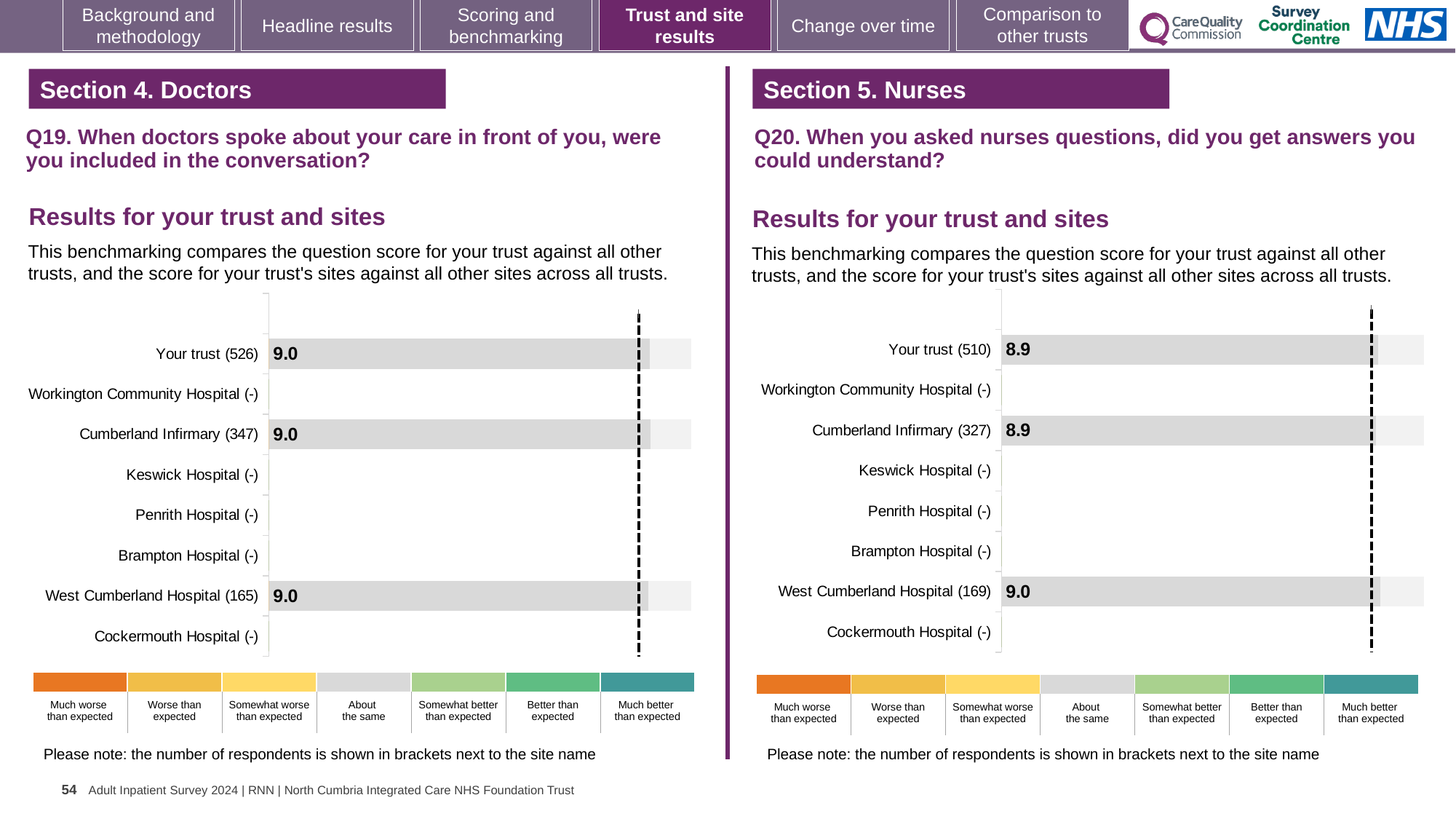
How many benchmark categories does the colour legend below the Q20 chart (right) list? 7 On the Q19 chart (left), how many categories have a plotted bar with a score? 3 On the Q19 chart (left), what is the score for West Cumberland Hospital (165)? 9.0 On the Q20 chart (right), which is larger: the score for West Cumberland Hospital (169) or the score for Cumberland Infirmary (327)? West Cumberland Hospital (169) What type of chart is used on the Q19 chart (left)? Bar chart On the Q20 chart (right), what is the difference between the score for West Cumberland Hospital (169) and the score for Your trust (510)? 0.1 On the Q20 chart (right), what is the score for Your trust (510)? 8.9 On the Q20 chart (right), what is the score for West Cumberland Hospital (169)? 9.0 On the Q20 chart (right), what is the score for Cumberland Infirmary (327)? 8.9 On the Q20 chart (right), which site has the highest score? West Cumberland Hospital (169) On the Q19 chart (left), what is the score for Your trust (526)? 9.0 How many site/trust categories are listed on the Q19 chart (left)? 8